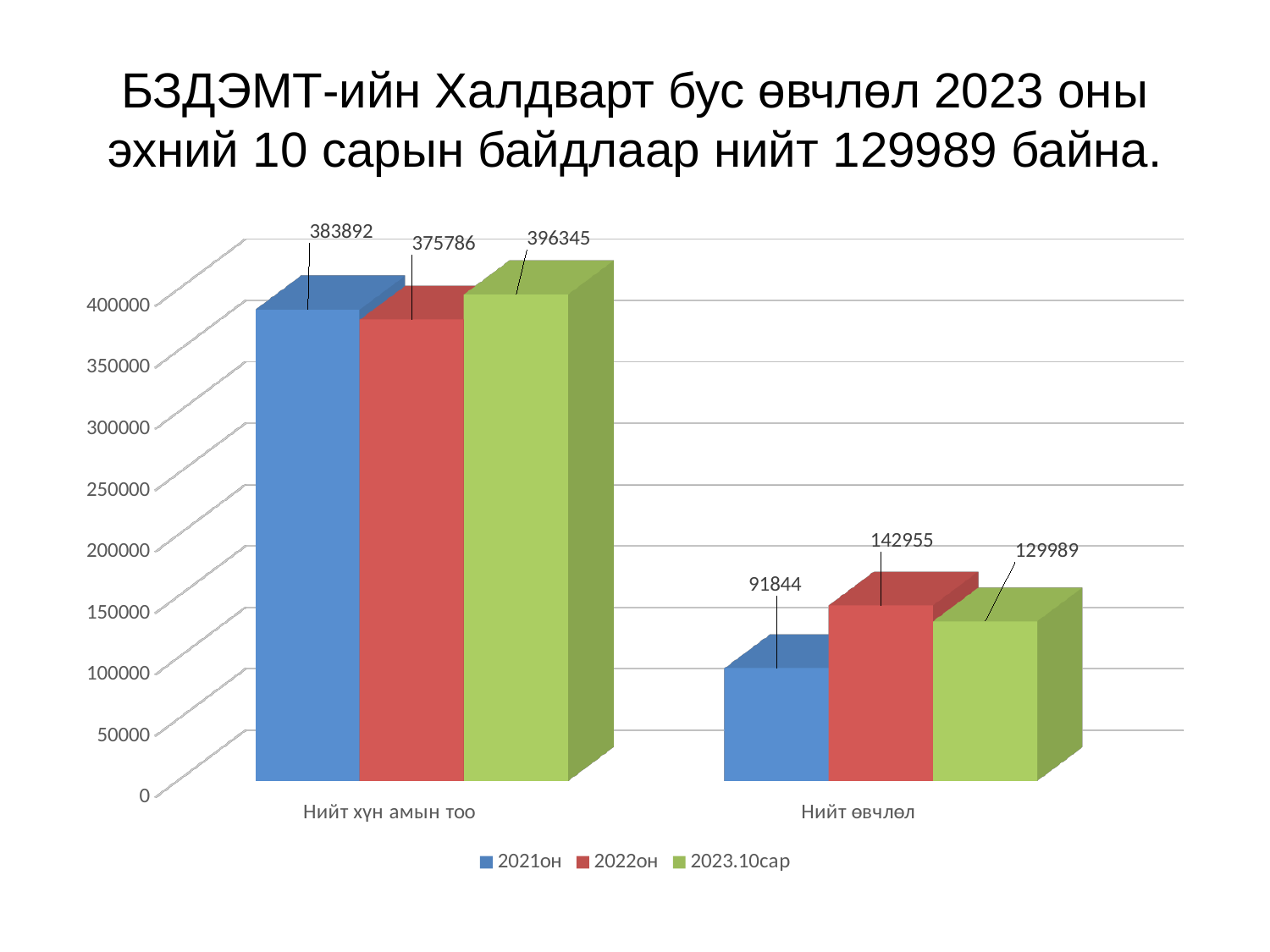
Is the value for 2021он in the Нийт өвчлөл category greater or less than 100000? less Which series has the highest value in the Нийт хүн амын тоо category? 2023.10сар What is the value for 2021он in the Нийт хүн амын тоо category? 383892 What is the value for 2022он in the Нийт өвчлөл category? 142955 What is the difference between the 2023.10сар and 2022он values in the Нийт хүн амын тоо category? 20559 What is the value for 2022он in the Нийт хүн амын тоо category? 375786 What is the value for 2023.10сар in the Нийт өвчлөл category? 129989 Which series has the lowest value in the Нийт өвчлөл category? 2021он Which is larger in the Нийт өвчлөл category: 2022он or 2023.10сар? 2022он How many series does the legend list? 3 What kind of chart is shown on the slide? bar chart What is the difference between the 2022он and 2021он values in the Нийт өвчлөл category? 51111